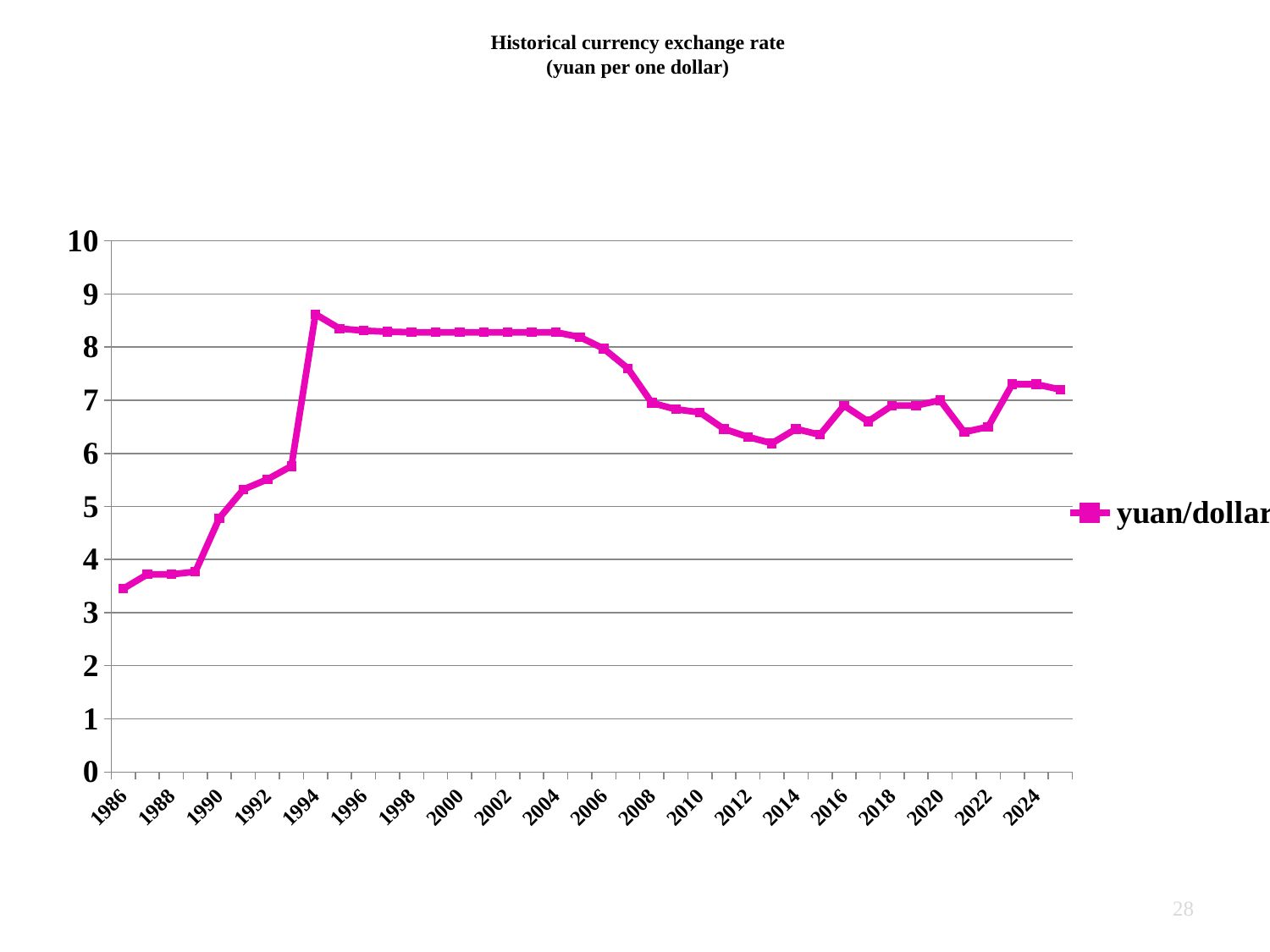
Is the value for 1992 greater or less than 5? greater Which is larger, the value for 1994 or the value for 2013? 1994 What kind of chart is shown on the slide? line chart Is the value for 1994 greater or less than 8? greater What is the name of the series shown in the legend? yuan/dollar In which year is the yuan/dollar value highest? 1994 How many series does the legend list? 1 What is the title of the chart? Historical currency exchange rate (yuan per one dollar) Is the value for 2013 greater or less than 7? less Does the yuan/dollar value rise or fall from 1986 to 1994? rise In which year is the yuan/dollar value lowest? 1986